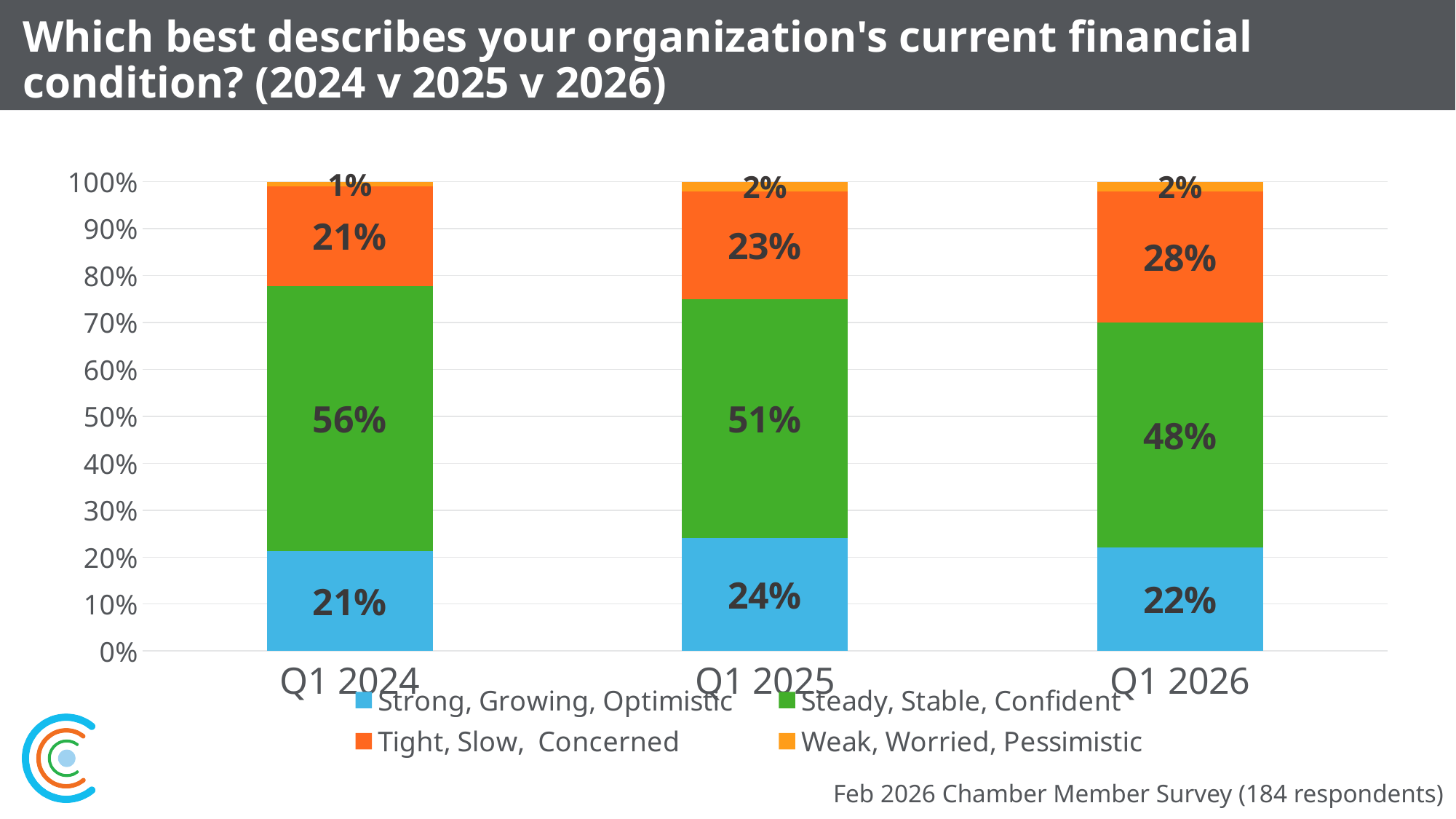
Does the "Steady, Stable, Confident" share rise or fall from Q1 2024 to Q1 2026? Fall How many series does the legend list? 4 In which quarter was the "Tight, Slow, Concerned" share the lowest? Q1 2024 In which quarter was the "Steady, Stable, Confident" share the highest? Q1 2024 How much higher is the "Tight, Slow, Concerned" share in Q1 2026 than in Q1 2025? 5 percentage points What percentage of respondents chose "Strong, Growing, Optimistic" in Q1 2025? 24% What percentage of respondents chose "Tight, Slow, Concerned" in Q1 2026? 28% Which is larger: the "Strong, Growing, Optimistic" share in Q1 2025 or in Q1 2026? Q1 2025 What percentage of respondents chose "Weak, Worried, Pessimistic" in Q1 2024? 1% What kind of chart is shown on the slide? Stacked bar chart What percentage of respondents chose "Steady, Stable, Confident" in Q1 2024? 56% How many quarters (categories) are shown on the x axis? 3